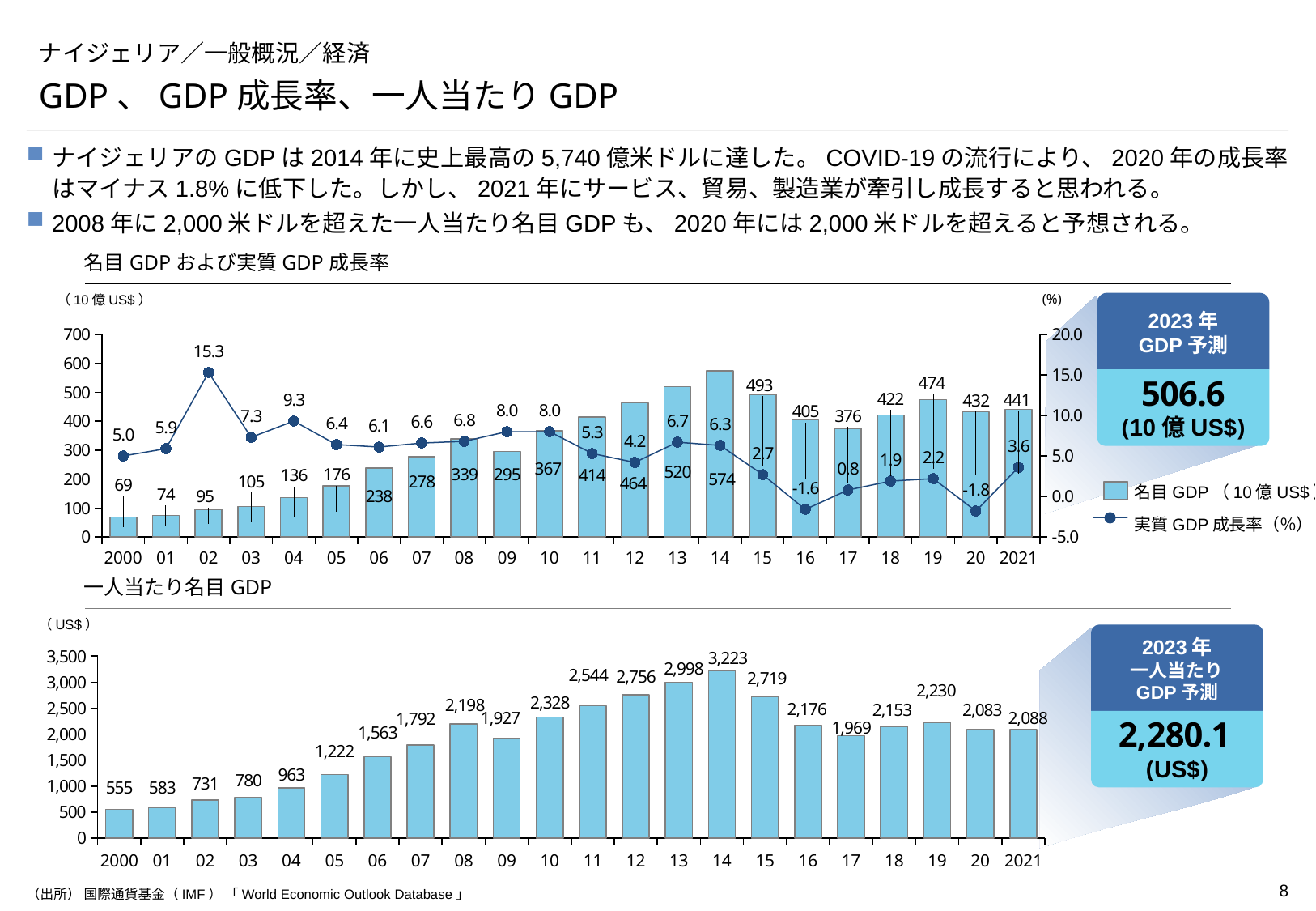
In the bottom chart (一人当たり名目 GDP), what is the value for 2014? 3,223 In the bottom chart (一人当たり名目 GDP), what is the difference between the values for 2021 and 2020? 5 In the top chart (名目 GDP および実質 GDP 成長率), what is the real GDP growth rate for 2002? 15.3 In the bottom chart (一人当たり名目 GDP), how many years are shown on the x axis? 22 In the top chart (名目 GDP および実質 GDP 成長率), what is the nominal GDP value for 2014? 574 In the top chart (名目 GDP および実質 GDP 成長率), how many series does the legend list? 2 In the top chart (名目 GDP および実質 GDP 成長率), which year has the highest nominal GDP? 14 In the top chart (名目 GDP および実質 GDP 成長率), what is the difference in nominal GDP between 2019 and 2020? 42 What type of chart is the bottom chart (一人当たり名目 GDP)? bar chart In the top chart (名目 GDP および実質 GDP 成長率), what is the real GDP growth rate for 2020? -1.8 In the bottom chart (一人当たり名目 GDP), which year has the lowest value? 2000 In the top chart (名目 GDP および実質 GDP 成長率), is the real GDP growth rate for 2016 higher or lower than for 2017? lower